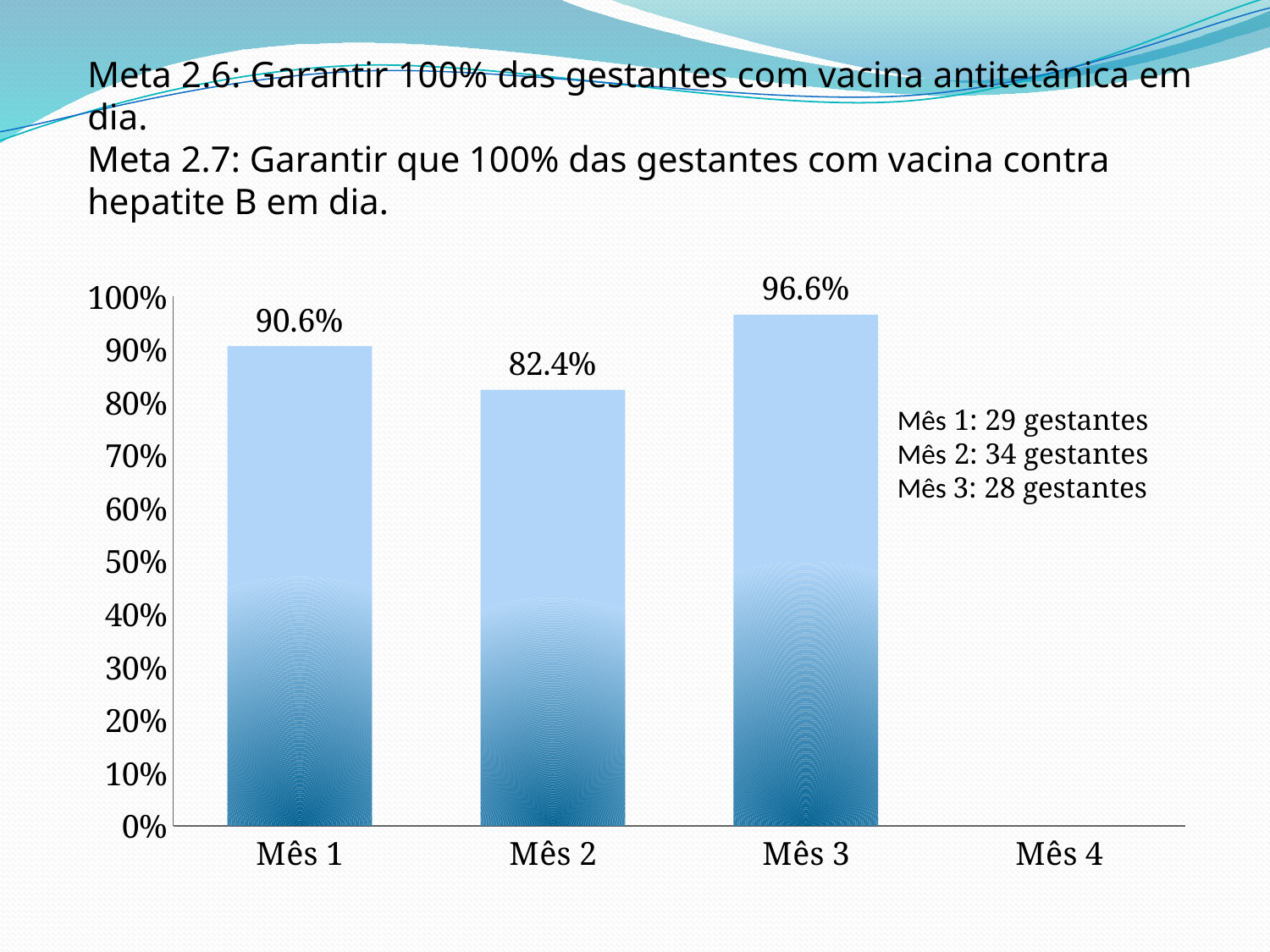
What is the value shown for Mês 3? 96.6% Which month with a plotted bar has the lowest value? Mês 2 What is the value shown for Mês 2? 82.4% According to the text next to the chart, how many gestantes were there in Mês 2? 34 gestantes How many month categories are shown on the x axis? 4 What is the difference between the values for Mês 3 and Mês 2? 14.2% What is the difference between the values for Mês 1 and Mês 2? 8.2% Is the value for Mês 2 greater or less than 90%? less What kind of chart is shown on the slide? bar chart What is the value shown for Mês 1? 90.6% Which month has the highest value? Mês 3 Which is larger, the value for Mês 1 or the value for Mês 2? Mês 1